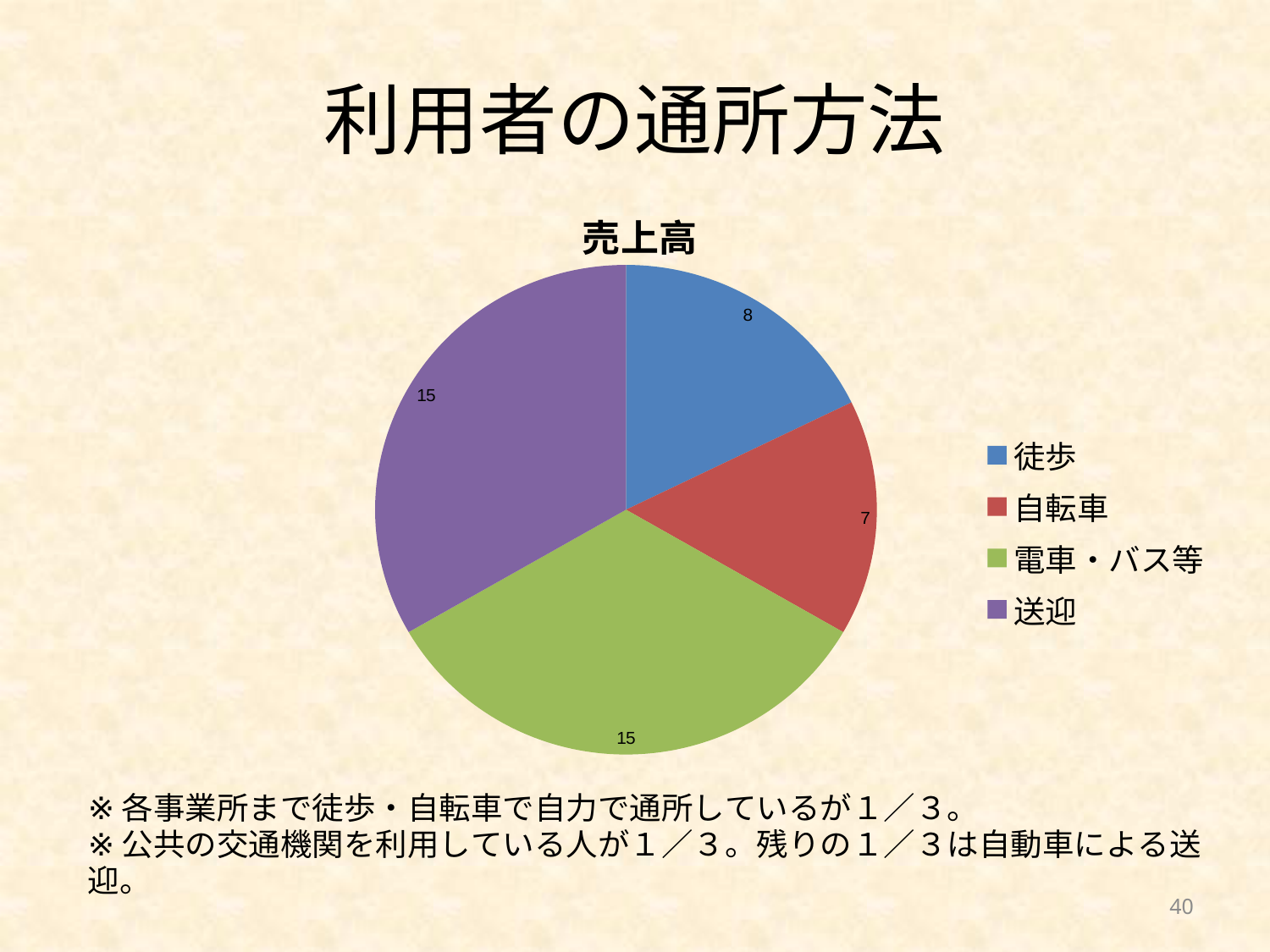
How many categories does the pie chart have? 4 What is the difference between the values for 送迎 and 徒歩? 7 What is the title of the chart? 売上高 What is the difference between the values for 徒歩 and 自転車? 1 What share of the pie does 送迎 represent? 33.3% What is the value for 送迎 in the pie chart? 15 What is the value for 徒歩 in the pie chart? 8 Which is larger, the value for 電車・バス等 or the value for 自転車? 電車・バス等 Which category has the smallest slice in the pie chart? 自転車 What is the value for 電車・バス等 in the pie chart? 15 What kind of chart is shown on the slide? Pie chart What is the value for 自転車 in the pie chart? 7